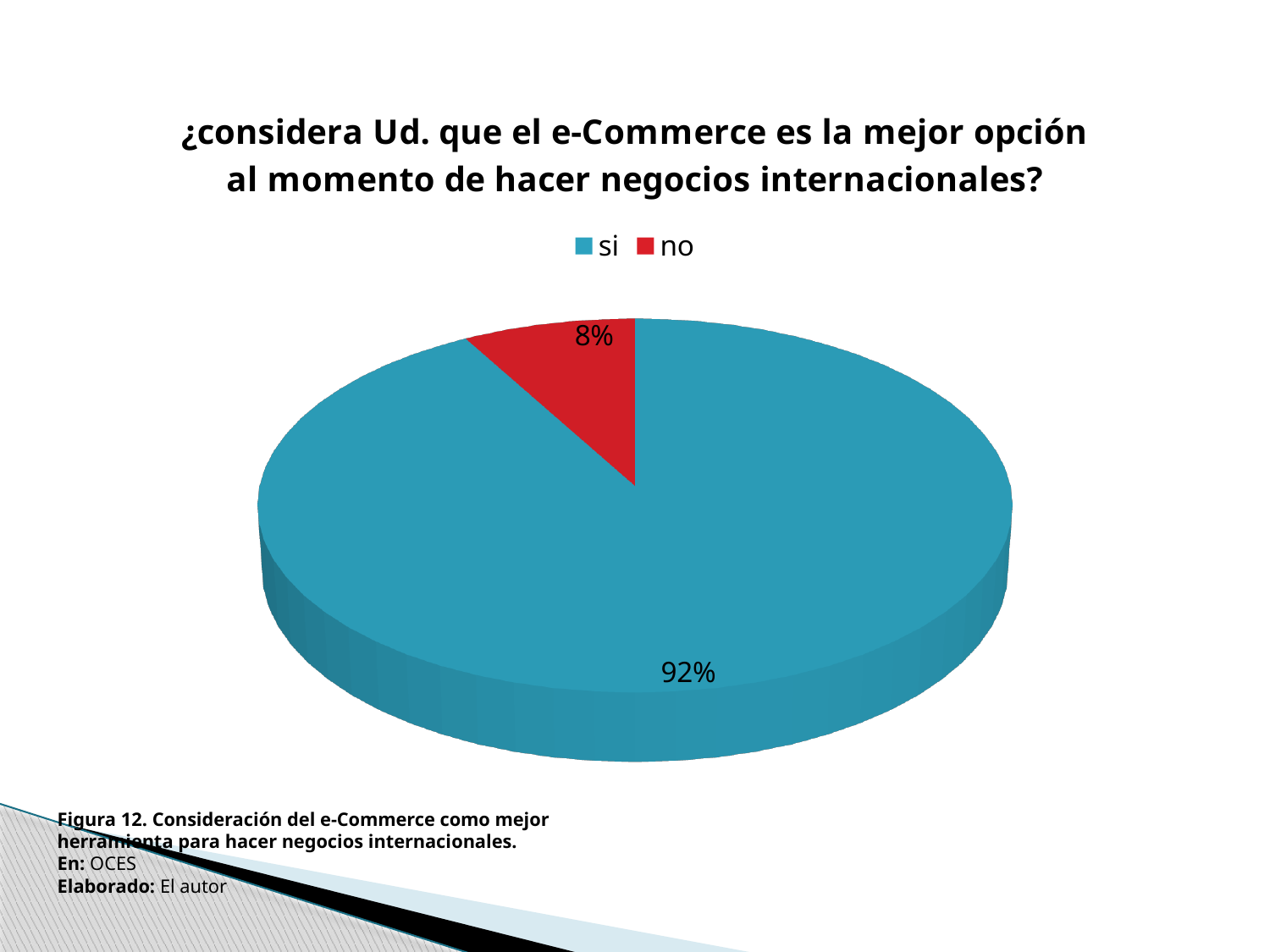
How many entries does the legend list? 2 What is the difference in percentage points between the "si" and "no" slices? 84 What colour is the "no" slice? red How many categories does the pie chart show? 2 What is the title of the chart? ¿considera Ud. que el e-Commerce es la mejor opción al momento de hacer negocios internacionales? What share of the pie does the "si" slice represent? 92% What kind of chart is shown on the slide? pie chart Which category has the largest slice of the pie? si Which category has the smallest slice of the pie? no Which is larger, the "si" slice or the "no" slice? si What share of the pie does the "no" slice represent? 8%